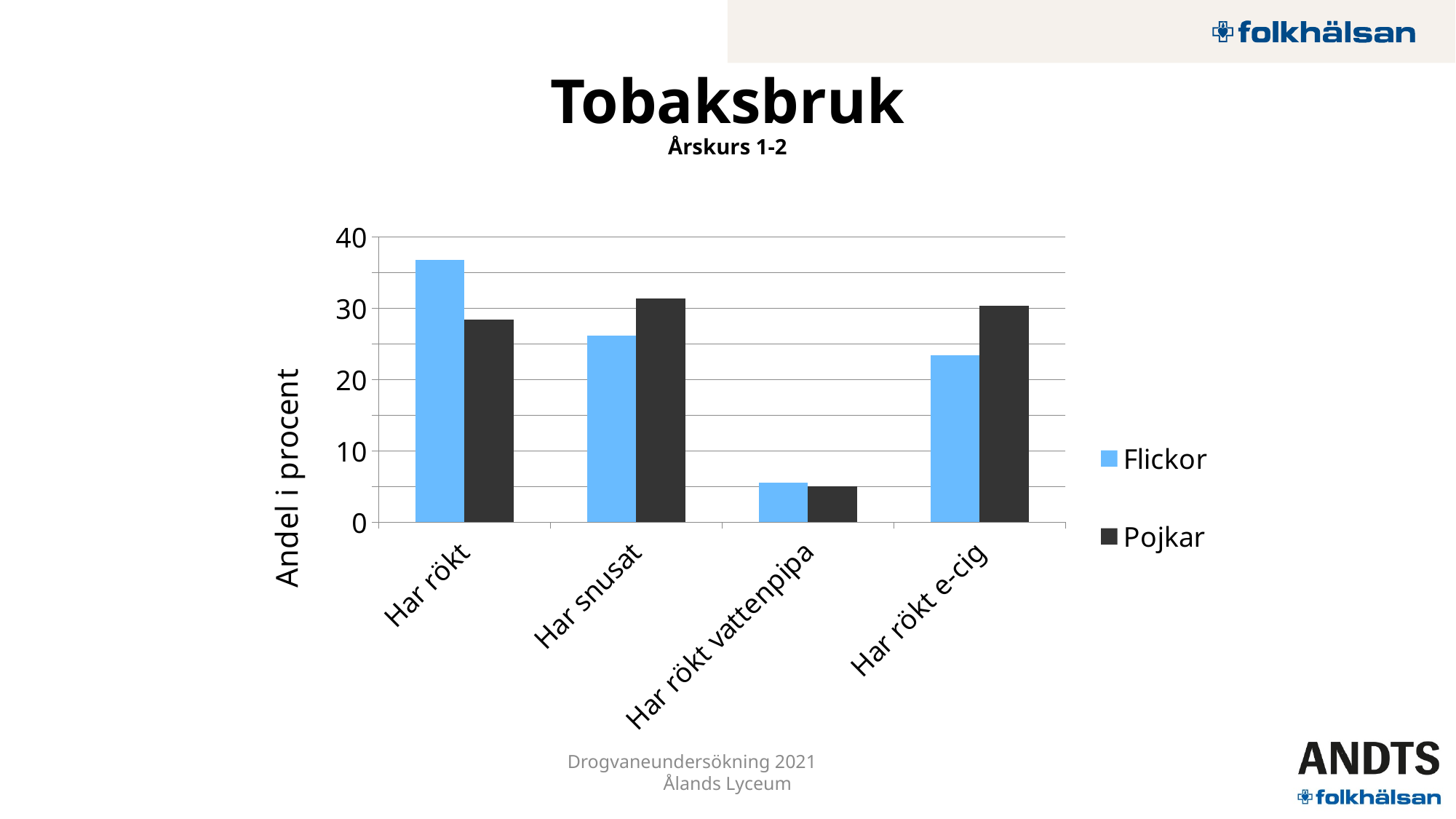
Is the Flickor value for Har rökt greater or less than 30? greater For which category is the Flickor value highest? Har rökt For Har rökt, which series has the larger value, Flickor or Pojkar? Flickor For Har snusat, which series has the larger value, Flickor or Pojkar? Pojkar For which category is the Flickor value lowest? Har rökt vattenpipa What is the label of the vertical axis? Andel i procent What kind of chart is shown on the slide? bar chart Is the Flickor value for Har rökt vattenpipa greater or less than 10? less For which category is the Pojkar value lowest? Har rökt vattenpipa What is the title of the chart on the slide? Tobaksbruk How many categories are shown on the x axis of the chart? 4 How many series does the legend list? 2